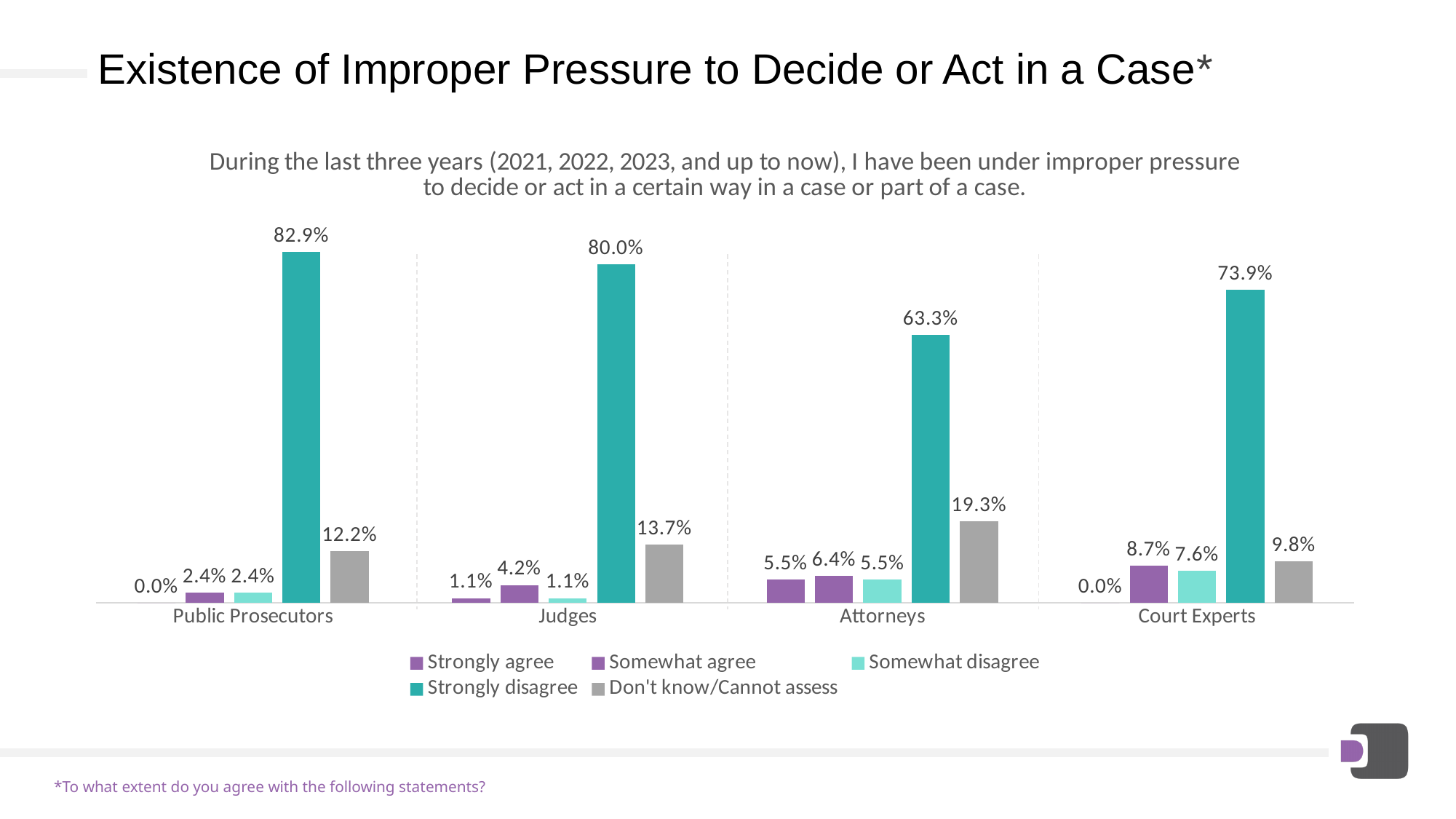
Which group has the lowest 'Strongly disagree' value? Attorneys Which is larger: the 'Don't know/Cannot assess' value for Judges or for Court Experts? Judges What is the 'Somewhat disagree' value for Judges? 1.1% What is the total of the 'Strongly agree' and 'Somewhat agree' values for Attorneys? 11.9% How many series does the legend list? 5 What kind of chart is shown on the slide? Bar chart How many groups (categories) are shown on the x axis? 4 What percentage of Court Experts somewhat agree with the statement? 8.7% What is the 'Don't know/Cannot assess' value for Attorneys? 19.3% What is the difference between the 'Strongly disagree' values for Public Prosecutors and Judges? 2.9% Which group has the highest 'Strongly disagree' value? Public Prosecutors What percentage of Public Prosecutors strongly disagree with the statement? 82.9%